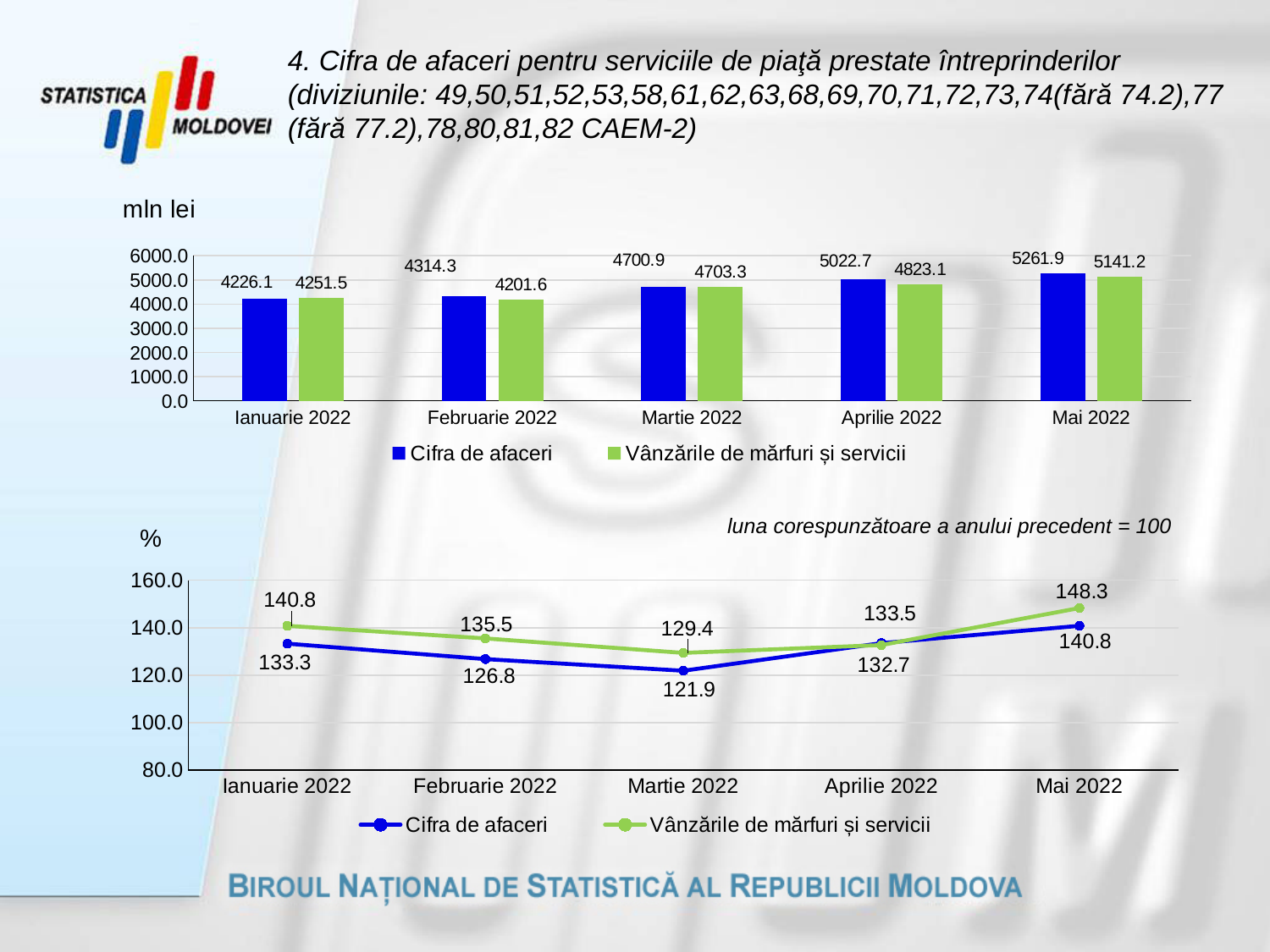
In the top chart (mln lei), what is the value of Cifra de afaceri for Mai 2022? 5261.9 What kind of chart is the top chart (mln lei)? Bar chart In the top chart (mln lei), what is the value of Vânzările de mărfuri și servicii for Februarie 2022? 4201.6 In the bottom chart (%), what is the value of Cifra de afaceri for Martie 2022? 121.9 In the top chart (mln lei), which month has the highest value for Cifra de afaceri? Mai 2022 In the top chart (mln lei), which month has the lowest value for Vânzările de mărfuri și servicii? Februarie 2022 In the bottom chart (%), what is the value of Vânzările de mărfuri și servicii for Mai 2022? 148.3 In the bottom chart (%), what is the difference between Vânzările de mărfuri și servicii and Cifra de afaceri for Mai 2022? 7.5 In the top chart (mln lei), which is larger for Aprilie 2022: Cifra de afaceri or Vânzările de mărfuri și servicii? Cifra de afaceri How many series does the legend of the bottom chart (%) list? 2 In the bottom chart (%), which month has the lowest value for Cifra de afaceri? Martie 2022 In the top chart (mln lei), what is the difference between Cifra de afaceri and Vânzările de mărfuri și servicii for Mai 2022? 120.7